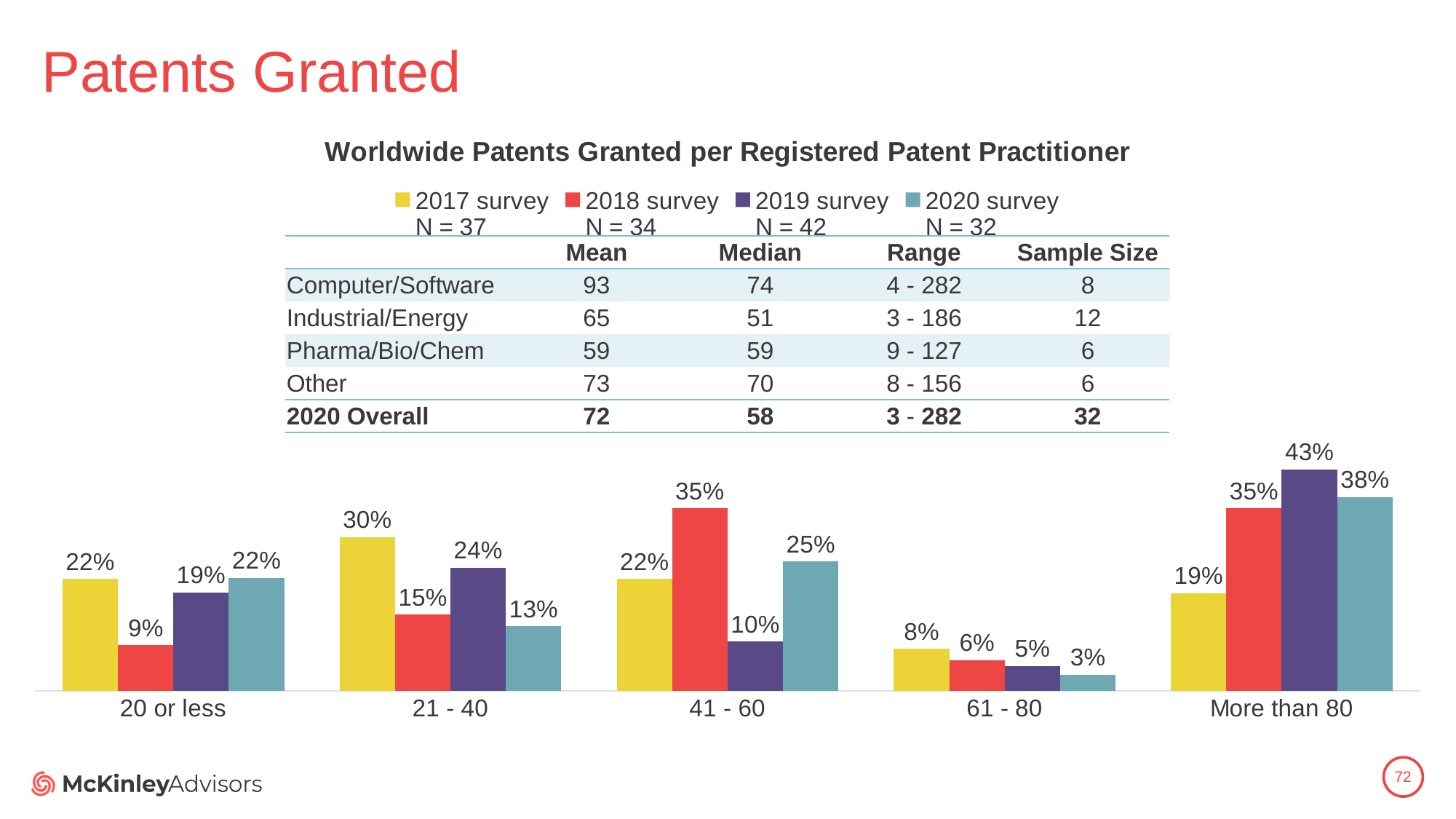
What is the title of the chart? Worldwide Patents Granted per Registered Patent Practitioner What kind of chart is shown on the slide? Bar chart Which category has the highest value for the 2017 survey? 21 - 40 What is the difference between the 2019 survey and 2018 survey values in the '41 - 60' category? 25% Which category has the lowest value for the 2020 survey? 61 - 80 What is the sample size (N) for the 2019 survey shown in the legend? 42 What is the value for the 2018 survey in the '20 or less' category? 9% Which is larger in the '21 - 40' category: the 2019 survey value or the 2020 survey value? 2019 survey What is the value for the 2019 survey in the 'More than 80' category? 43% How many categories are shown on the x axis of the chart? 5 How many series does the chart legend list? 4 What is the value for the 2020 survey in the '41 - 60' category? 25%